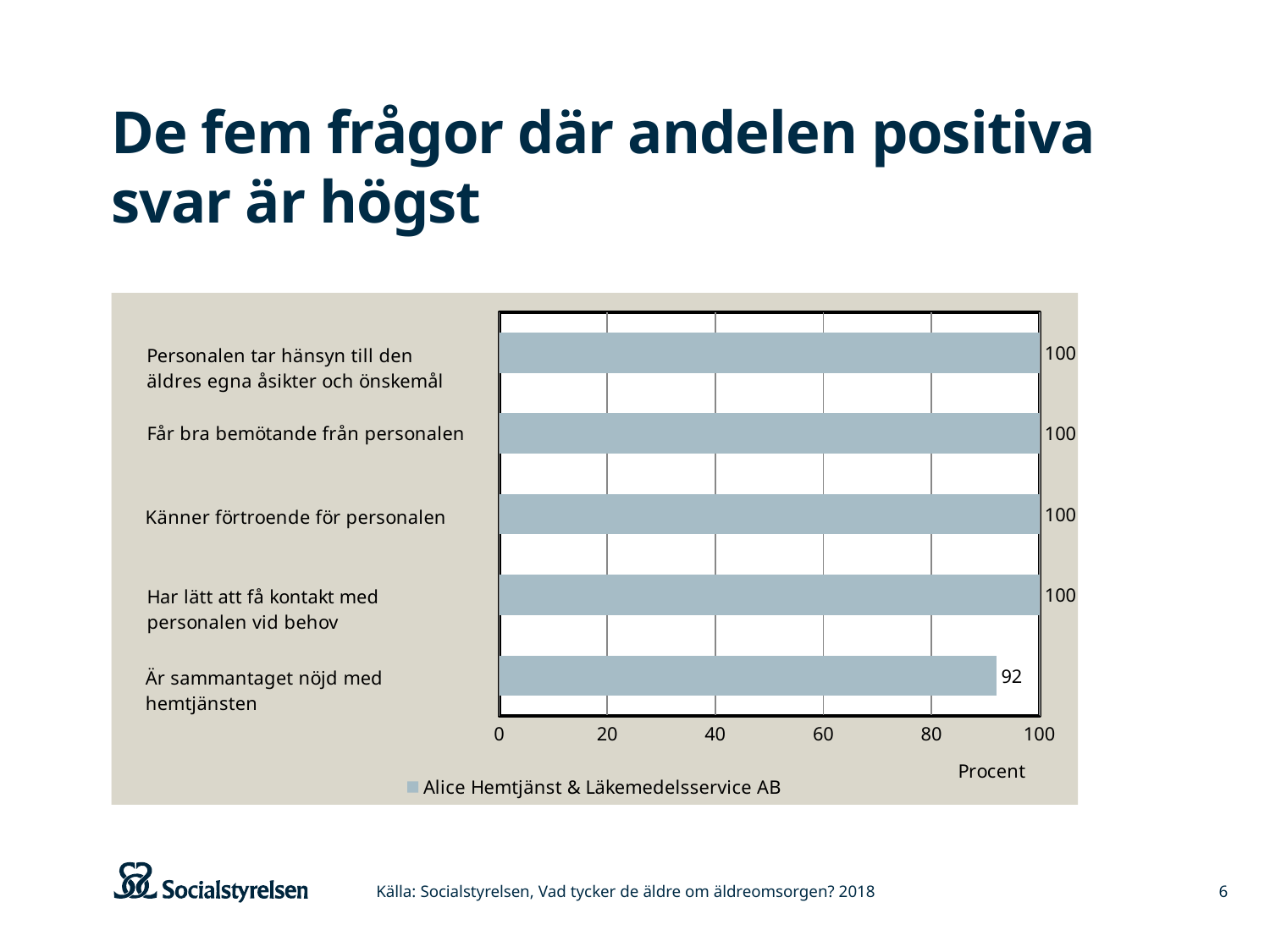
Which is larger: the value for "Personalen tar hänsyn till den äldres egna åsikter och önskemål" or the value for "Är sammantaget nöjd med hemtjänsten"? Personalen tar hänsyn till den äldres egna åsikter och önskemål What kind of chart is shown on the slide? Bar chart How many categories are shown in the chart? 5 Which category has the lowest value? Är sammantaget nöjd med hemtjänsten What is the value for "Är sammantaget nöjd med hemtjänsten"? 92 What is the label on the horizontal axis? Procent Is the value for "Är sammantaget nöjd med hemtjänsten" greater or less than 80? greater What is the value for "Får bra bemötande från personalen"? 100 What is the difference between the value for "Har lätt att få kontakt med personalen vid behov" and the value for "Är sammantaget nöjd med hemtjänsten"? 8 How many series does the legend list? 1 What is the value for "Känner förtroende för personalen"? 100 What is the series name shown in the legend? Alice Hemtjänst & Läkemedelsservice AB